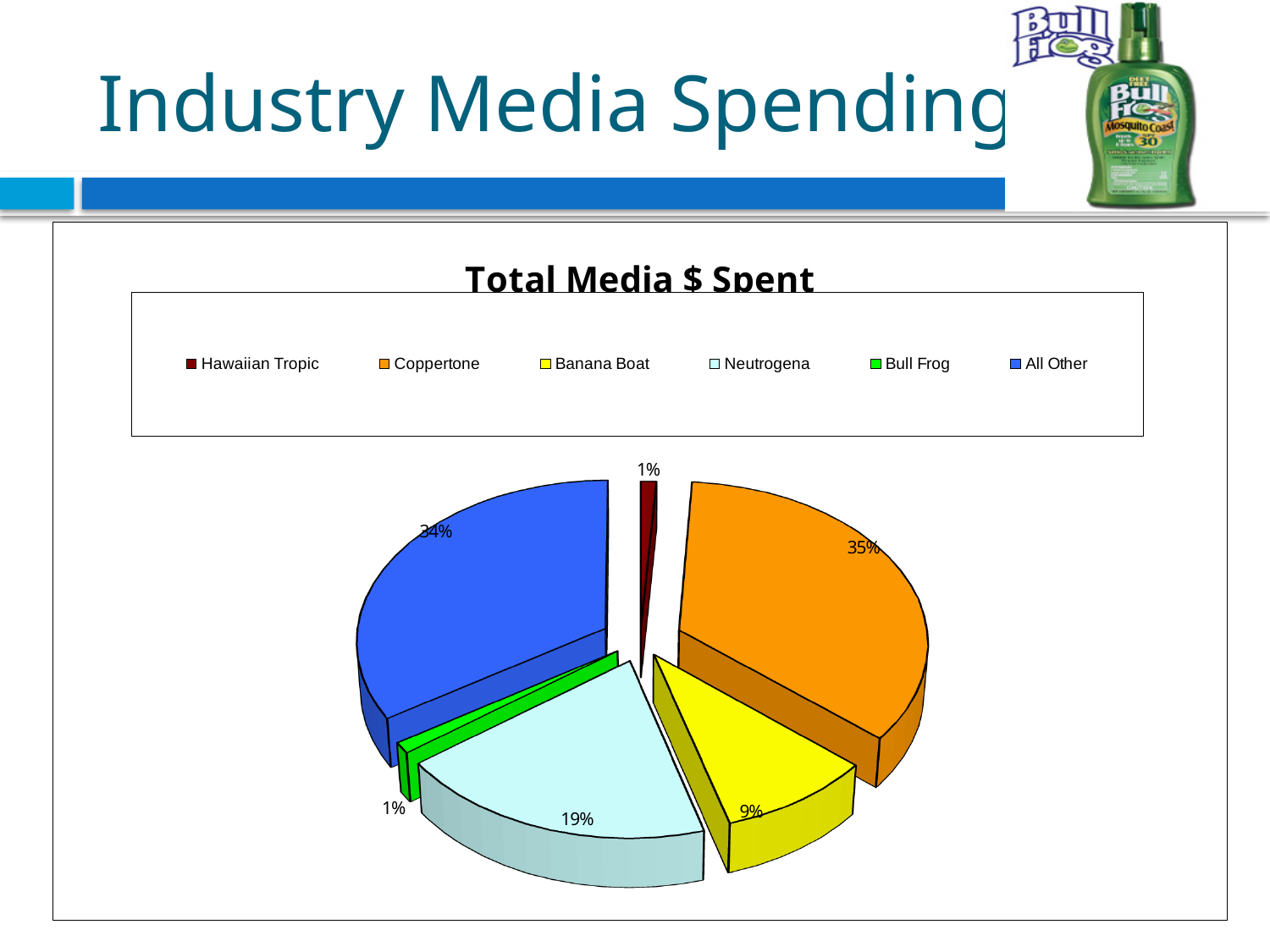
What percentage is shown for Bull Frog? 1% What share does the All Other slice represent? 34% What percentage of the pie is Neutrogena? 19% Which has the larger share, Neutrogena or Banana Boat? Neutrogena How many slices does the pie chart have? 6 What share of total media spending does Coppertone account for? 35% What percentage is shown for Hawaiian Tropic? 1% By how many percentage points does Coppertone's share exceed the All Other share? 1 percentage point What is the title of the chart? Total Media $ Spent Which brand has the largest share of total media spending? Coppertone What type of chart is shown on the slide? Pie chart What is the value shown for Banana Boat? 9%